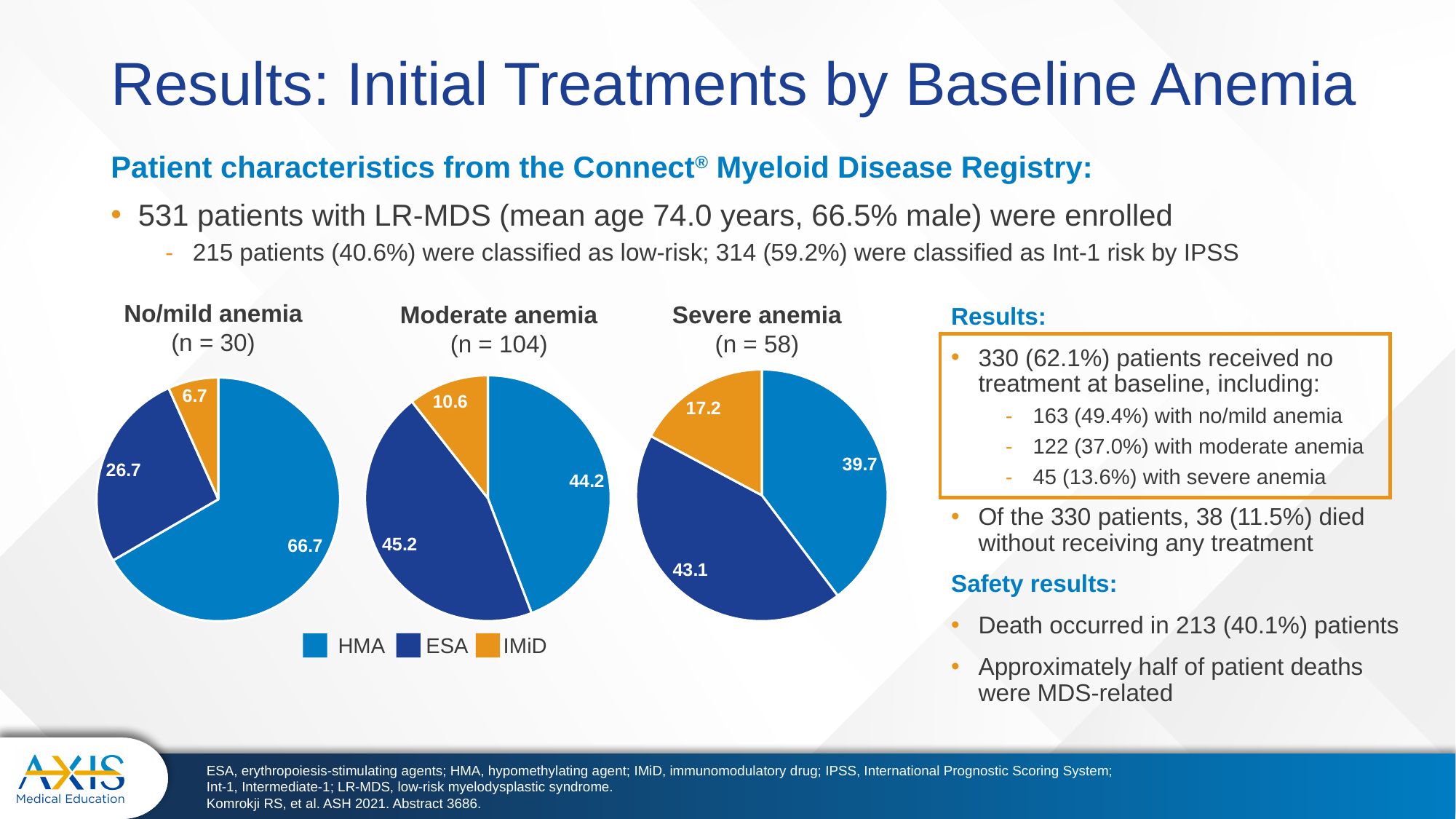
In the Moderate anemia pie chart, what is the difference between the HMA and IMiD values? 33.6 How many entries does the shared legend list for the pie charts? 3 How many slices does the Severe anemia pie chart have? 3 In the Severe anemia pie chart, which treatment has the largest slice? ESA What is the sample size (n) shown for the Moderate anemia pie chart? 104 In the No/mild anemia pie chart, which is larger, the ESA slice or the IMiD slice? ESA Which colour represents IMiD in the pie charts? Orange In the Severe anemia pie chart, what is the value for IMiD? 17.2 In the No/mild anemia pie chart, what is the value for HMA? 66.7 What kind of chart is used to show initial treatments for each anemia group? Pie chart In the Moderate anemia pie chart, what is the value for ESA? 45.2 In the No/mild anemia pie chart, which treatment has the smallest slice? IMiD